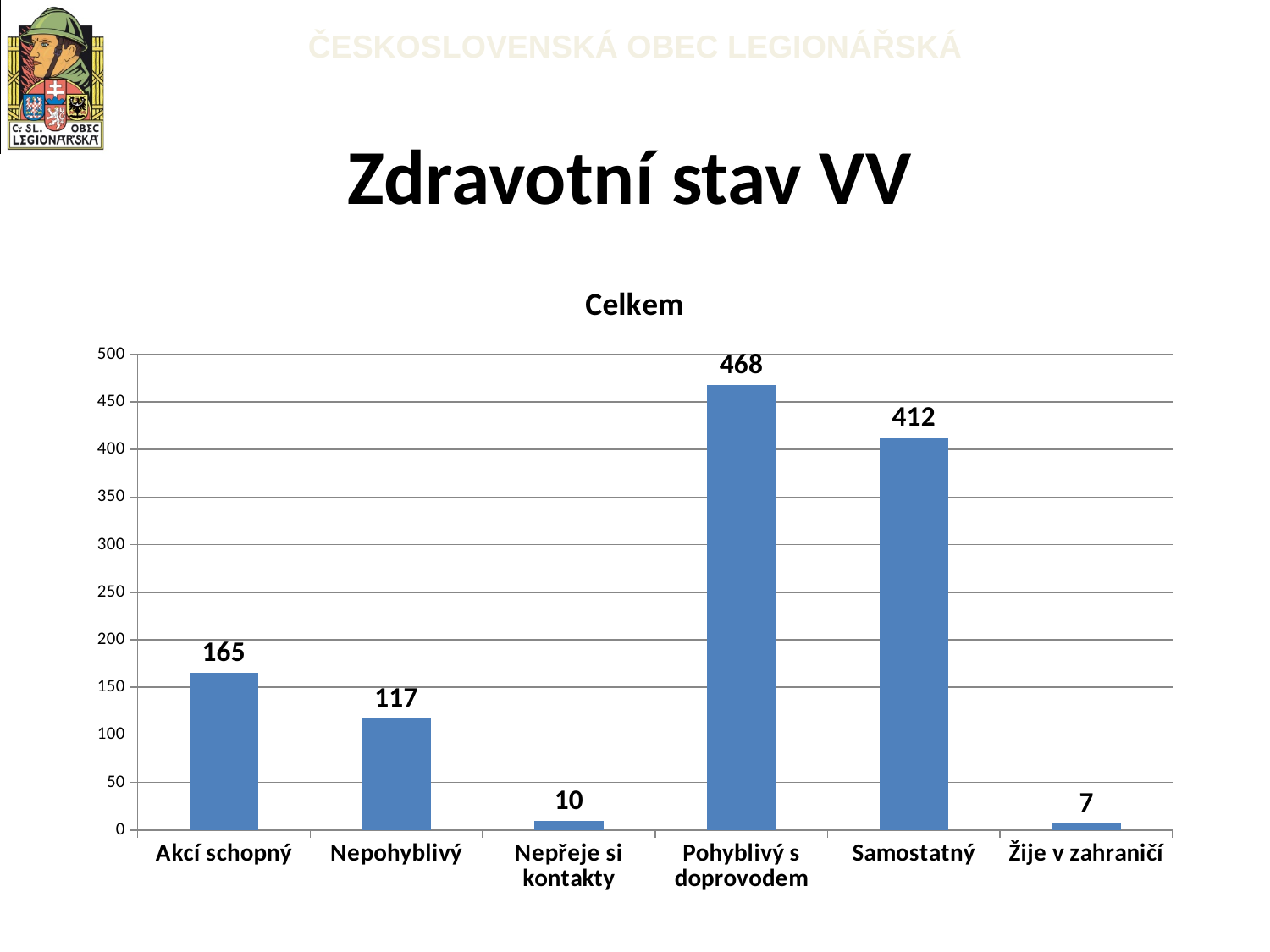
Which category has the lowest value? Žije v zahraničí What is the value for Žije v zahraničí? 7 What is the value for Akcí schopný? 165 What is the difference between the values for Pohyblivý s doprovodem and Samostatný? 56 Which category has the highest value? Pohyblivý s doprovodem What is the title of the chart? Celkem What is the difference between the values for Akcí schopný and Nepohyblivý? 48 Which is larger, the value for Samostatný or the value for Akcí schopný? Samostatný What kind of chart is shown on the slide? bar chart What is the value for Pohyblivý s doprovodem? 468 Is the value for Nepohyblivý greater or less than 150? less How many categories are shown on the x axis? 6